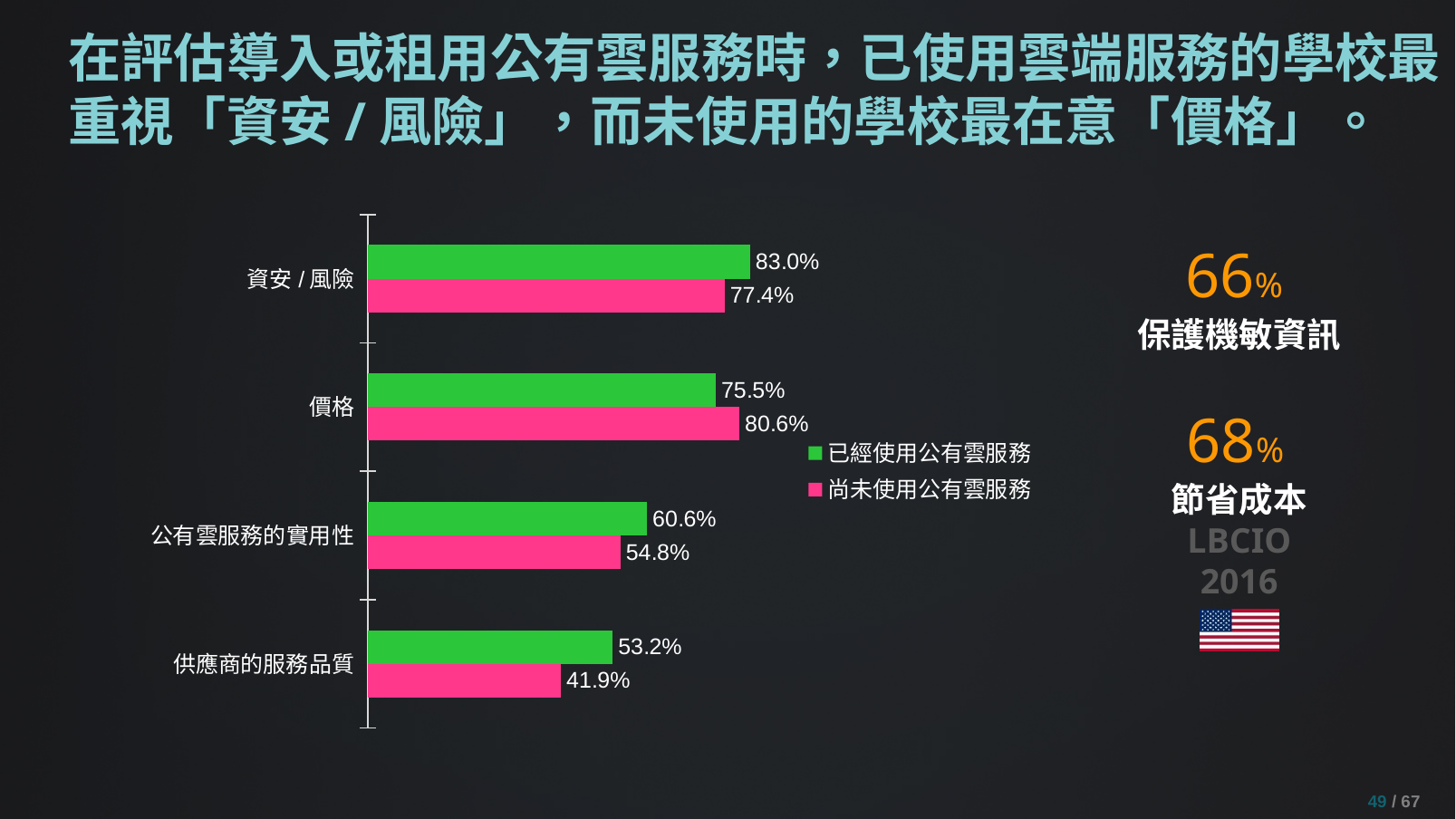
What is the difference between the two series for 公有雲服務的實用性? 5.8% For 價格, which series has the larger value? 尚未使用公有雲服務 What is the value for 資安 / 風險 in the 已經使用公有雲服務 series? 83.0% Which colour represents the 尚未使用公有雲服務 series? Pink What is the value for 價格 in the 尚未使用公有雲服務 series? 80.6% What is the difference between the 已經使用公有雲服務 and 尚未使用公有雲服務 values for 供應商的服務品質? 11.3% What is the value for 供應商的服務品質 in the 尚未使用公有雲服務 series? 41.9% Which category has the lowest value in the 尚未使用公有雲服務 series? 供應商的服務品質 What type of chart is shown on the slide? Bar chart Which category has the highest value in the 已經使用公有雲服務 series? 資安 / 風險 How many categories are shown on the chart? 4 How many series does the legend list? 2